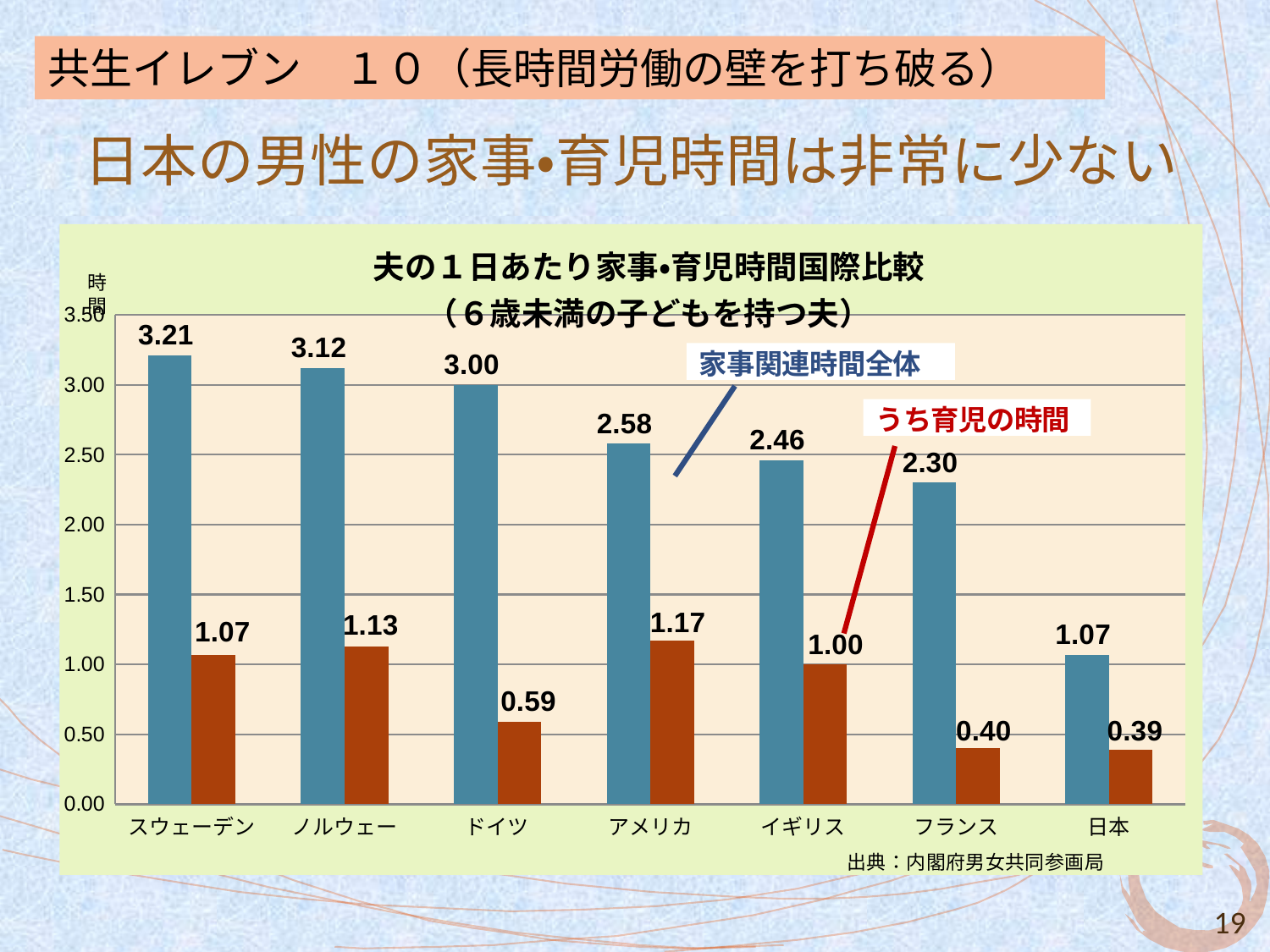
What kind of chart is this? bar chart How many countries are shown on the x axis? 7 Which country has the highest 家事関連時間全体 value? スウェーデン What is the title of the chart? 夫の１日あたり家事•育児時間国際比較（６歳未満の子どもを持つ夫） How many data series does the chart show? 2 What is the difference between the 家事関連時間全体 values for スウェーデン and 日本? 2.14 Which country has the highest うち育児の時間 value? アメリカ What is the value of うち育児の時間 for ドイツ? 0.59 Which country has the lowest 家事関連時間全体 value? 日本 What is the value of うち育児の時間 for 日本? 0.39 What is the value of 家事関連時間全体 for スウェーデン? 3.21 Which is larger, the うち育児の時間 value for ノルウェー or for イギリス? ノルウェー